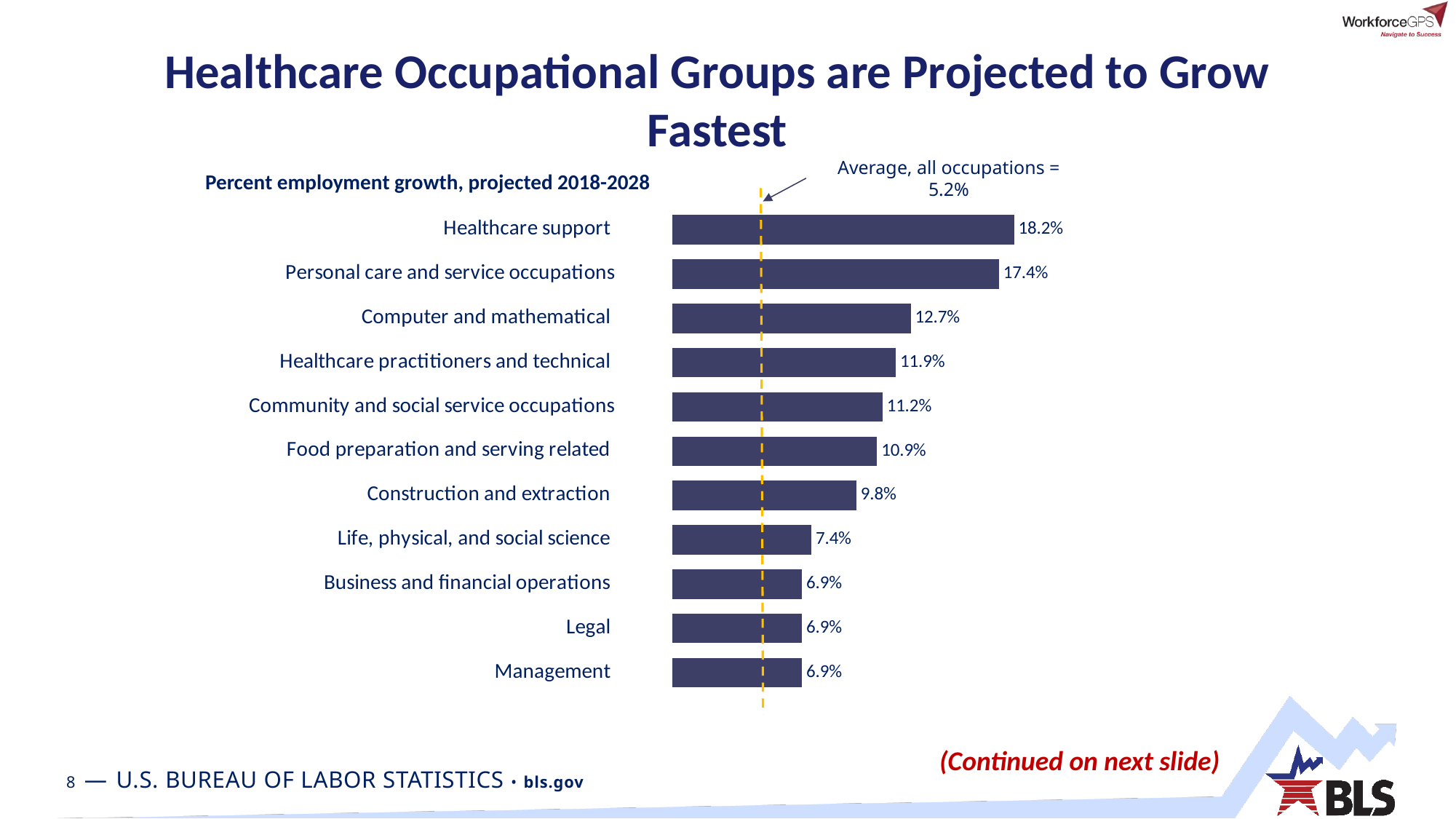
What type of chart is shown on the slide? Bar chart Which has a higher projected growth, Life, physical, and social science or Construction and extraction? Construction and extraction How many occupational groups are shown in the chart? 11 What is the projected percent employment growth for Healthcare support? 18.2% What is the projected percent employment growth for Construction and extraction? 9.8% Which has a higher projected growth, Community and social service occupations or Food preparation and serving related? Community and social service occupations What is the projected percent employment growth for Computer and mathematical? 12.7% Which occupational group has the highest projected employment growth? Healthcare support What is the difference in projected growth between Computer and mathematical and Healthcare practitioners and technical? 0.8% What is the difference in projected growth between Healthcare support and Personal care and service occupations? 0.8% What is the average projected employment growth for all occupations shown by the dashed line? 5.2% What is the projected percent employment growth for Legal? 6.9%